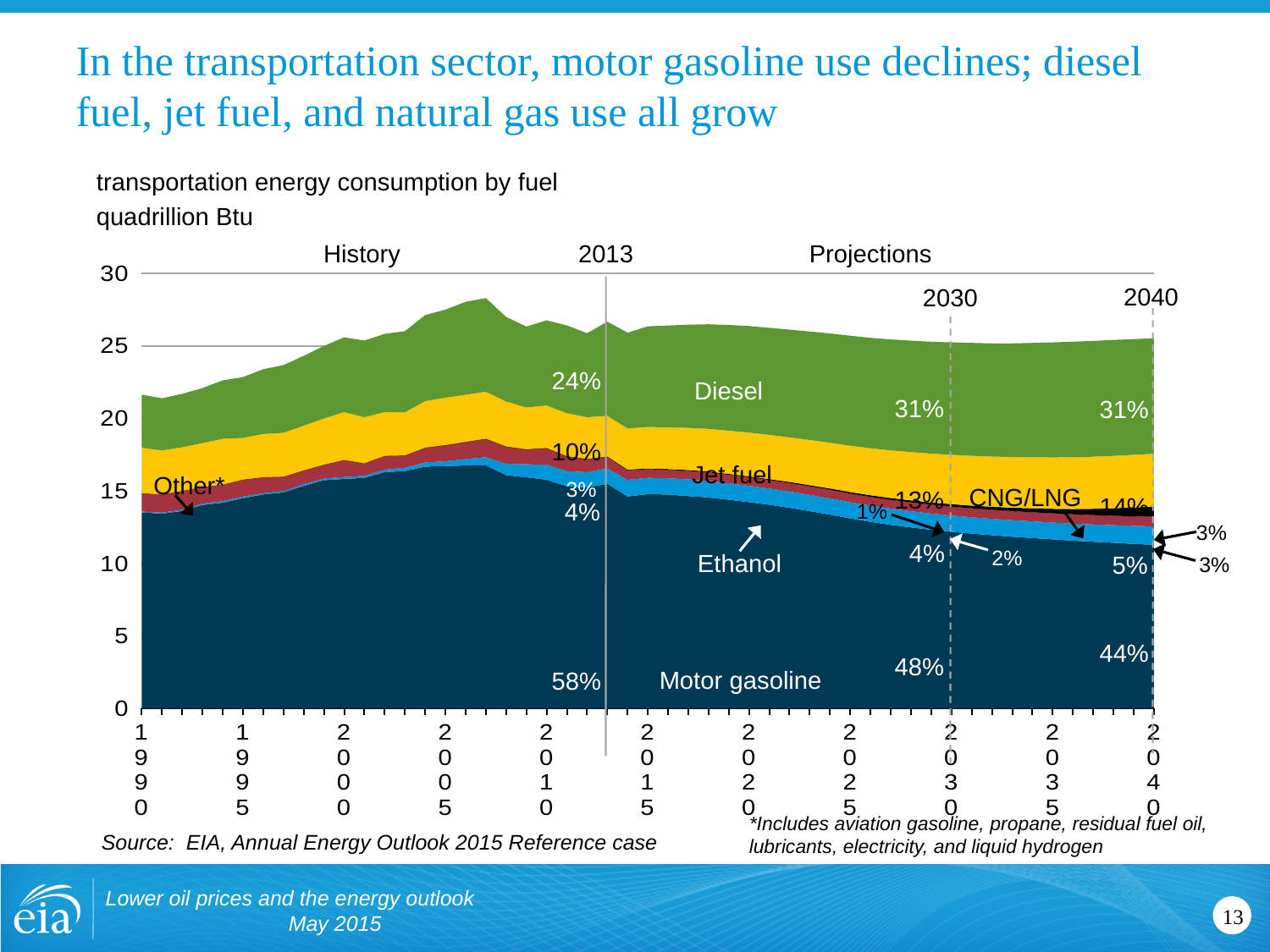
Does the motor gasoline share rise or fall from 2013 to 2040? fall What share of transportation energy consumption does ethanol account for in 2040? 5% Which fuel has the largest share of transportation energy consumption in 2040? Motor gasoline By how many percentage points does the motor gasoline share fall between 2013 and 2040? 14 percentage points What kind of chart is shown on the slide? stacked area chart What share of transportation energy consumption does motor gasoline account for in 2040? 44% What share of transportation energy consumption does motor gasoline account for in 2013? 58% What share of transportation energy consumption does jet fuel account for in 2040? 14% Is total transportation energy consumption in 1990 greater or less than 25 quadrillion Btu? less What share of transportation energy consumption does diesel account for in 2030? 31% What share of transportation energy consumption does jet fuel account for in 2013? 10% Is the diesel share larger in 2013 or in 2030? 2030